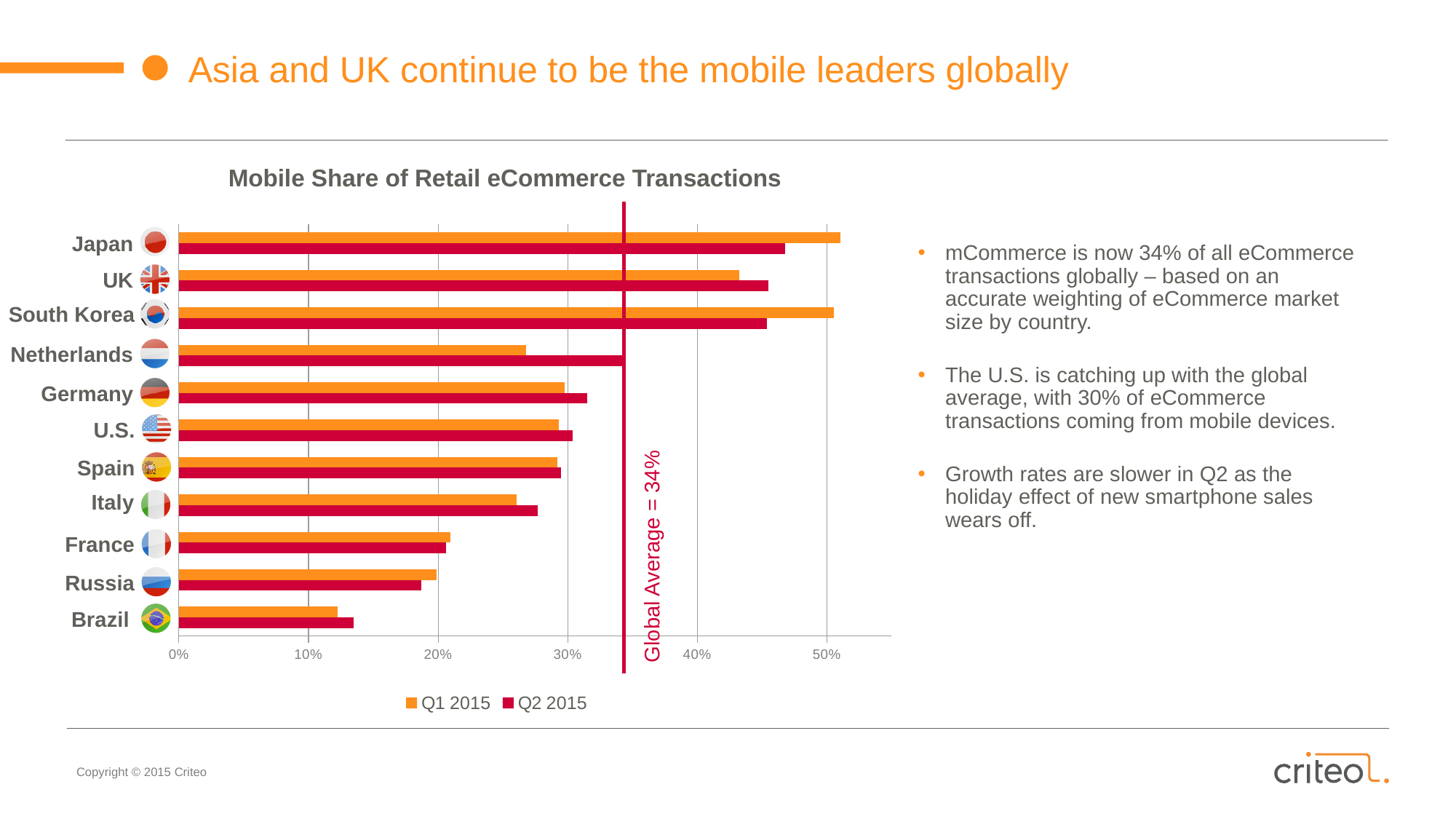
How many countries are shown in the chart? 11 Which country has the lowest Q2 2015 mobile share? Brazil Is the Q2 2015 value for UK greater or less than 40%? greater How many series does the legend list? 2 What global average value is marked by the vertical line on the chart? 34% What kind of chart is shown on the slide? Bar chart For Japan, which is larger: the Q1 2015 value or the Q2 2015 value? Q1 2015 For Netherlands, which is larger: the Q1 2015 value or the Q2 2015 value? Q2 2015 Is the Q2 2015 value for Italy greater or less than 30%? less Which country has the lowest Q1 2015 mobile share? Brazil Is the Q1 2015 value for Netherlands greater or less than 30%? less